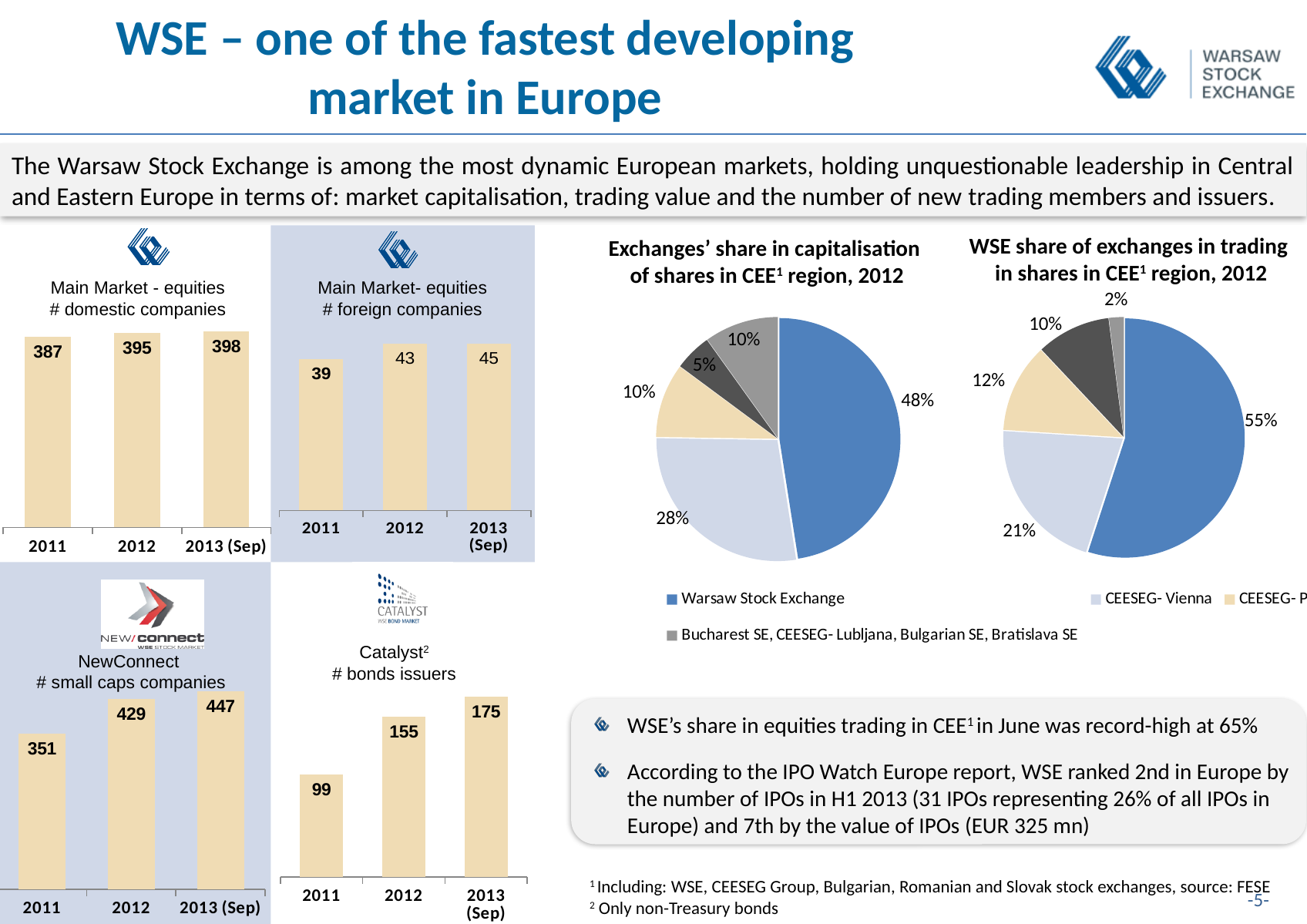
In the 'Main Market - equities # domestic companies' chart, what is the value for 2012? 395 In the pie chart 'Exchanges' share in capitalisation of shares in CEE region, 2012', what share does CEESEG- Vienna have? 28% In the pie chart 'WSE share of exchanges in trading in shares in CEE region, 2012', what share does the Warsaw Stock Exchange have? 55% In the pie chart 'Exchanges' share in capitalisation of shares in CEE region, 2012', what share does the Warsaw Stock Exchange have? 48% In the 'NewConnect # small caps companies' chart, which is larger, the 2011 value or the 2012 value? 2012 In the 'Main Market- equities # foreign companies' chart, what is the value for 2011? 39 In the 'Catalyst # bonds issuers' chart, how much higher is the 2012 value than the 2011 value? 56 In the 'Main Market- equities # foreign companies' chart, do the values rise or fall from 2011 to 2013 (Sep)? rise In the 'Catalyst # bonds issuers' chart, what is the value for 2013 (Sep)? 175 How many years are shown on the x axis of the 'NewConnect # small caps companies' chart? 3 In the 'Catalyst # bonds issuers' chart, which year has the highest value? 2013 (Sep) In the 'NewConnect # small caps companies' chart, what is the difference between the 2013 (Sep) value and the 2011 value? 96